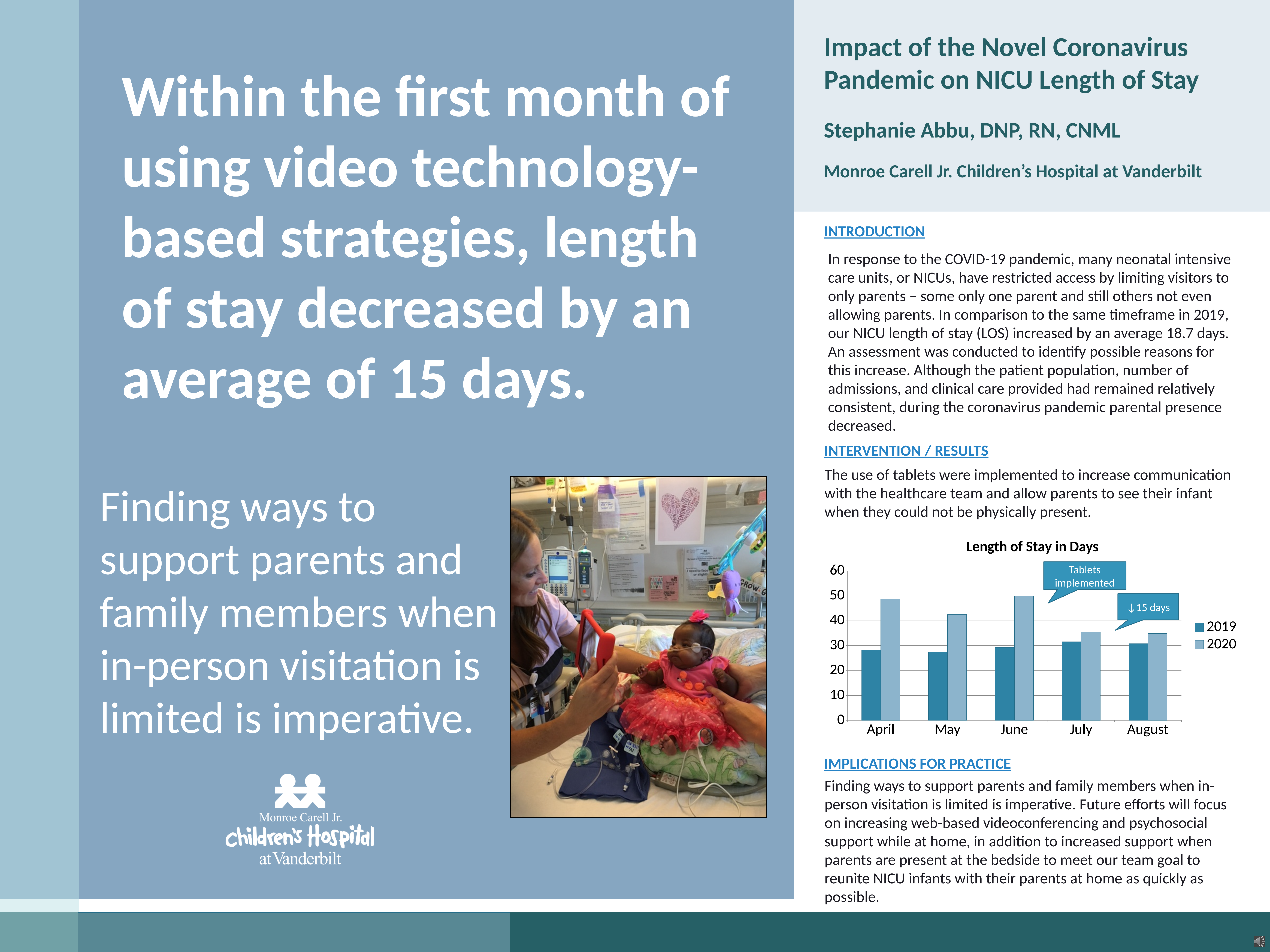
What does the callout box above the June/July bars in the 'Length of Stay in Days' chart say? Tablets implemented In the 'Length of Stay in Days' chart, is the 2019 value for April greater or less than 30? less How many series does the legend of the 'Length of Stay in Days' chart list? 2 In the 'Length of Stay in Days' chart, is the 2020 value for April greater or less than 40? greater Which two years are listed in the legend of the 'Length of Stay in Days' chart? 2019 and 2020 In the 'Length of Stay in Days' chart, which is larger: the 2020 value for June or the 2020 value for August? June What kind of chart is shown under 'Length of Stay in Days'? bar chart In the 'Length of Stay in Days' chart, is the 2019 value for May greater or less than 30? less In the 'Length of Stay in Days' chart, do the 2020 values rise or fall from June to August? fall How many months are shown on the x axis of the 'Length of Stay in Days' chart? 5 In the 'Length of Stay in Days' chart, which is larger for April: the 2019 value or the 2020 value? 2020